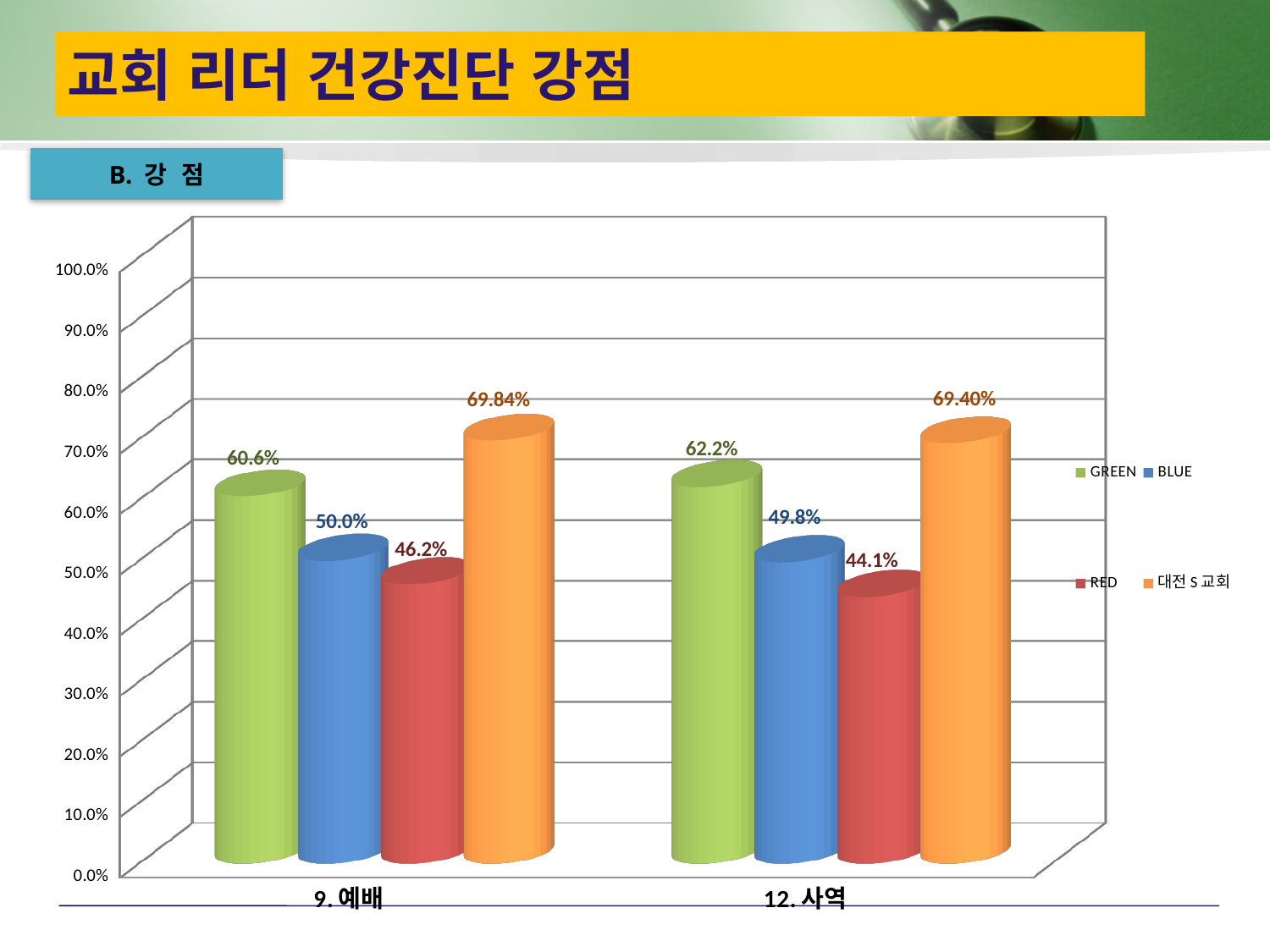
What is the value for GREEN in the 9. 예배 category? 60.6% What is the value for BLUE in the 9. 예배 category? 50.0% Which is larger: the RED value for 9. 예배 or the RED value for 12. 사역? 9. 예배 What colour represents the 대전 S 교회 series? Orange Which series has the highest value in the 9. 예배 category? 대전 S 교회 What is the difference between the GREEN values for 12. 사역 and 9. 예배? 1.6% How many categories are shown on the x axis? 2 What is the value for RED in the 12. 사역 category? 44.1% How many series does the legend list? 4 What kind of chart is shown on the slide? Bar chart Which series has the lowest value in the 12. 사역 category? RED What is the value for 대전 S 교회 in the 12. 사역 category? 69.40%